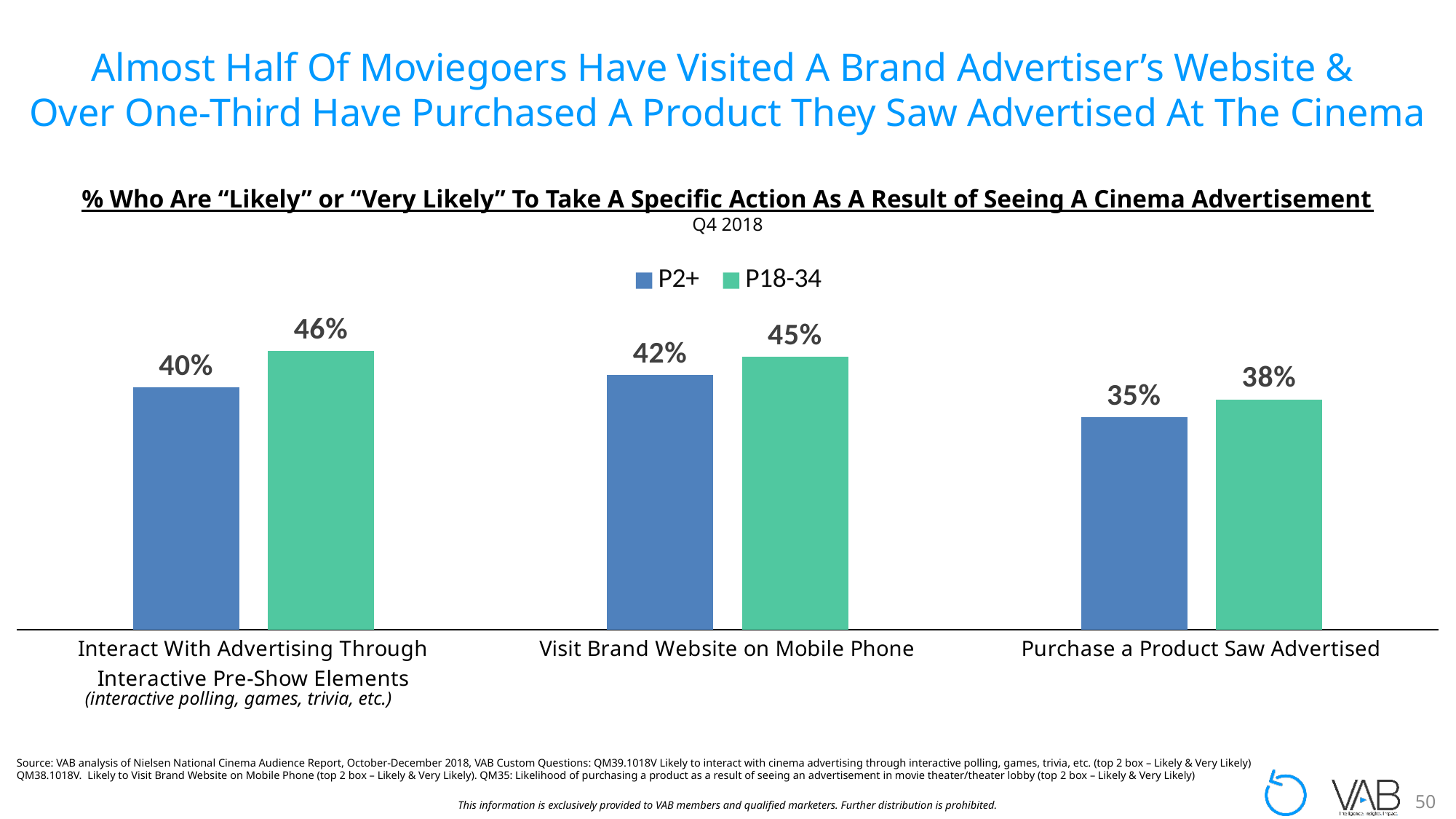
Which colour represents the P18-34 series in the legend? Green What is the P18-34 value for Purchase a Product Saw Advertised? 38% What is the P18-34 value for Interact With Advertising Through Interactive Pre-Show Elements? 46% How many categories are shown on the x axis? 3 Which category has the highest P18-34 value? Interact With Advertising Through Interactive Pre-Show Elements Which is larger for Visit Brand Website on Mobile Phone, the P2+ value or the P18-34 value? P18-34 What is the difference between the P18-34 and P2+ values for Interact With Advertising Through Interactive Pre-Show Elements? 6% What is the difference between the P2+ values for Visit Brand Website on Mobile Phone and Purchase a Product Saw Advertised? 7% Which category has the lowest P2+ value? Purchase a Product Saw Advertised What is the P2+ value for Visit Brand Website on Mobile Phone? 42% What kind of chart is shown on the slide? Bar chart How many series does the legend list? 2